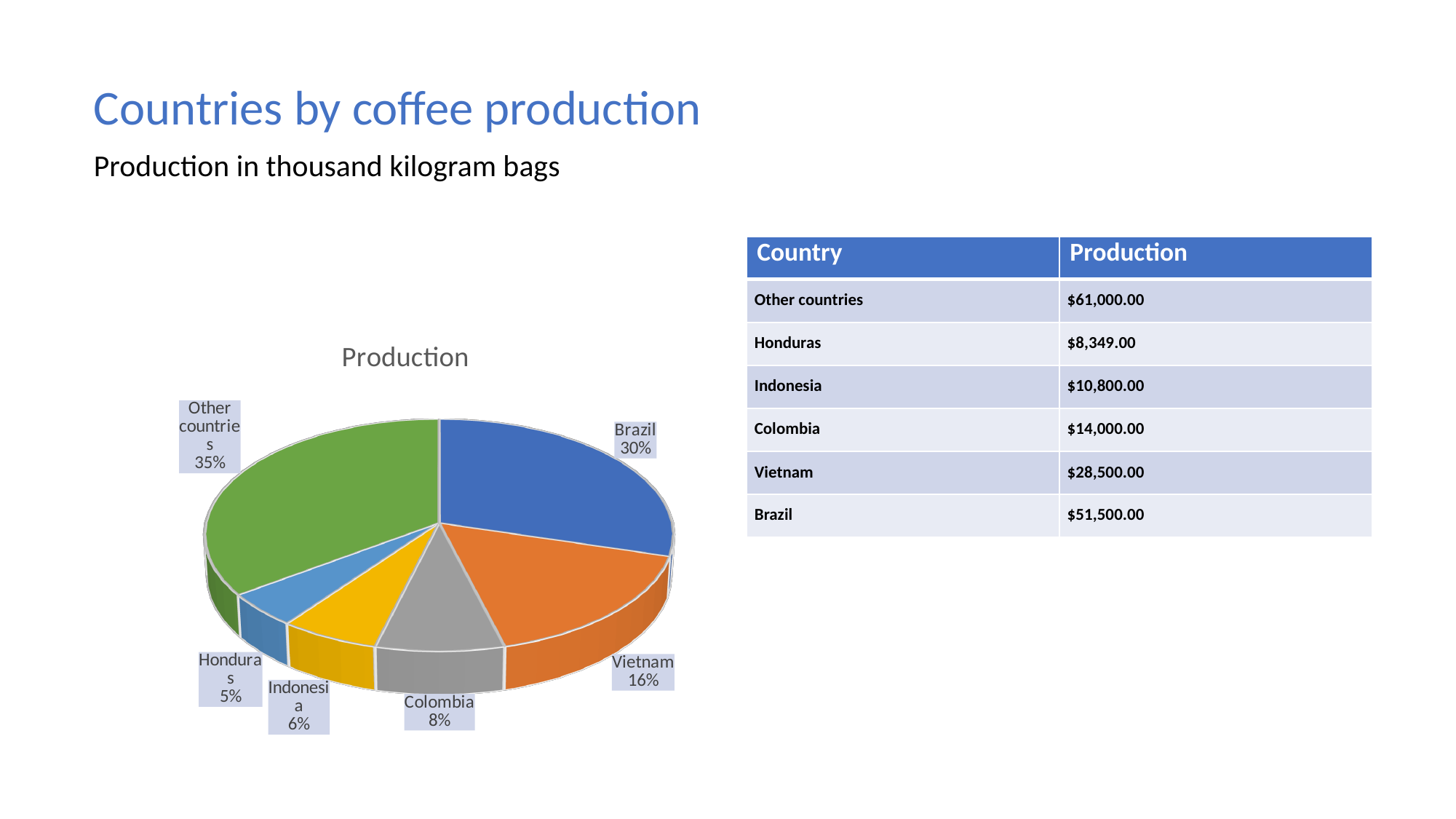
Which slice is larger, Indonesia or Colombia? Colombia What share of the pie does Colombia have? 8% What is the title of the chart? Production How many slices does the pie chart have? 6 Which slice of the pie chart is the largest? Other countries What type of chart is shown on the slide? pie chart Which slice of the pie chart is the smallest? Honduras What share of the pie does Vietnam have? 16% What share of the pie does Brazil have? 30% What colour is the Brazil slice in the pie chart? blue What is the difference in percentage points between the Brazil slice and the Vietnam slice? 14